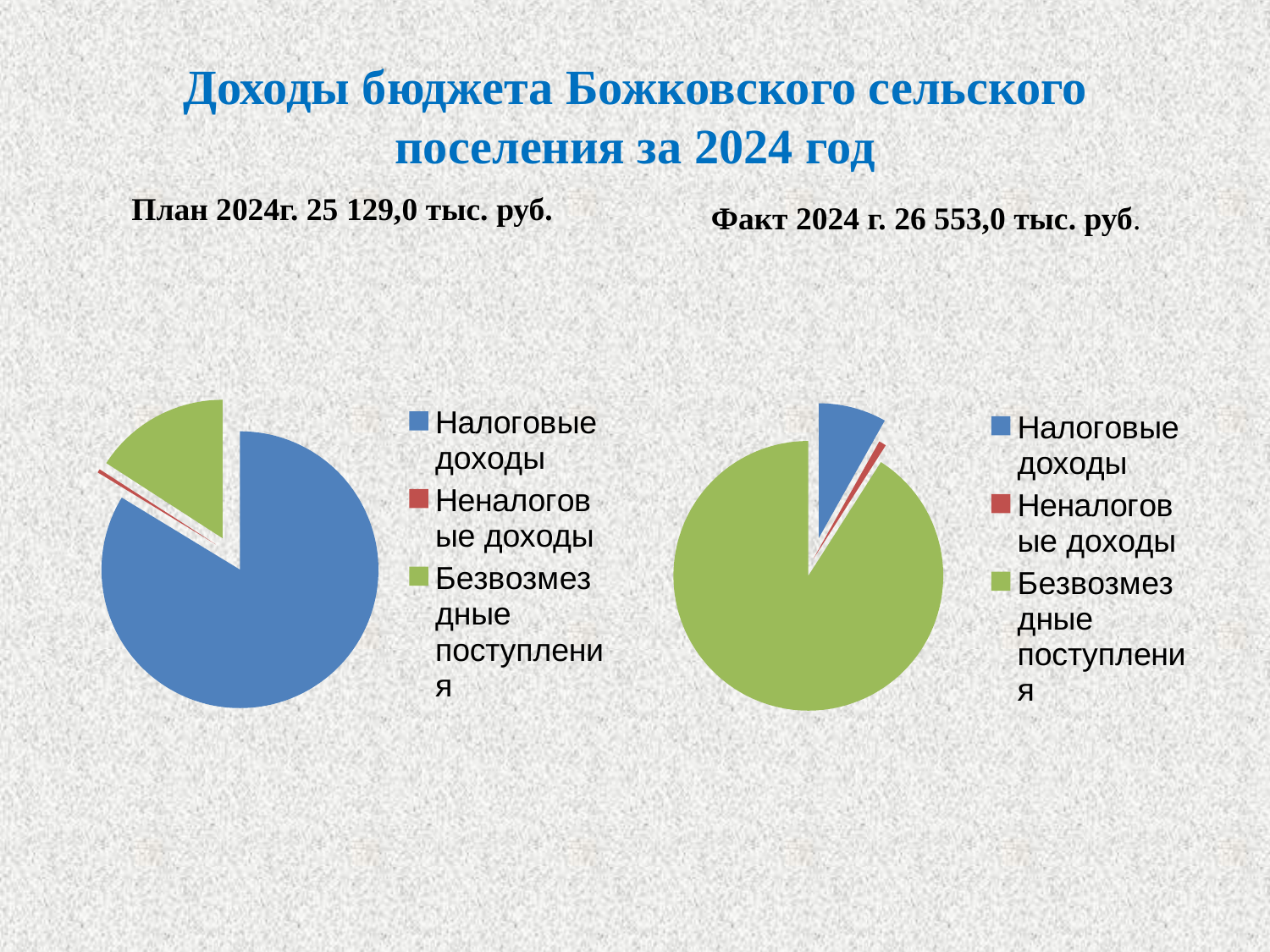
In the left chart (План 2024г.), which category has the largest slice? Налоговые доходы In the right chart (Факт 2024 г.), which category has the smallest slice? Неналоговые доходы What kind of chart is the right chart (Факт 2024 г.)? pie chart In the left chart (План 2024г.), which slice is larger: Налоговые доходы or Безвозмездные поступления? Налоговые доходы In the right chart (Факт 2024 г.), which slice is larger: Налоговые доходы or Безвозмездные поступления? Безвозмездные поступления In the right chart (Факт 2024 г.), what colour represents Безвозмездные поступления? green In the right chart (Факт 2024 г.), which category has the largest slice? Безвозмездные поступления In the left chart (План 2024г.), which category has the smallest slice? Неналоговые доходы In the right chart (Факт 2024 г.), how many entries does the legend list? 3 What total amount is stated in the heading above the left chart (План 2024г.)? 25 129,0 тыс. руб. In the left chart (План 2024г.), how many slices does the pie have? 3 What kind of chart is the left chart (План 2024г.)? pie chart